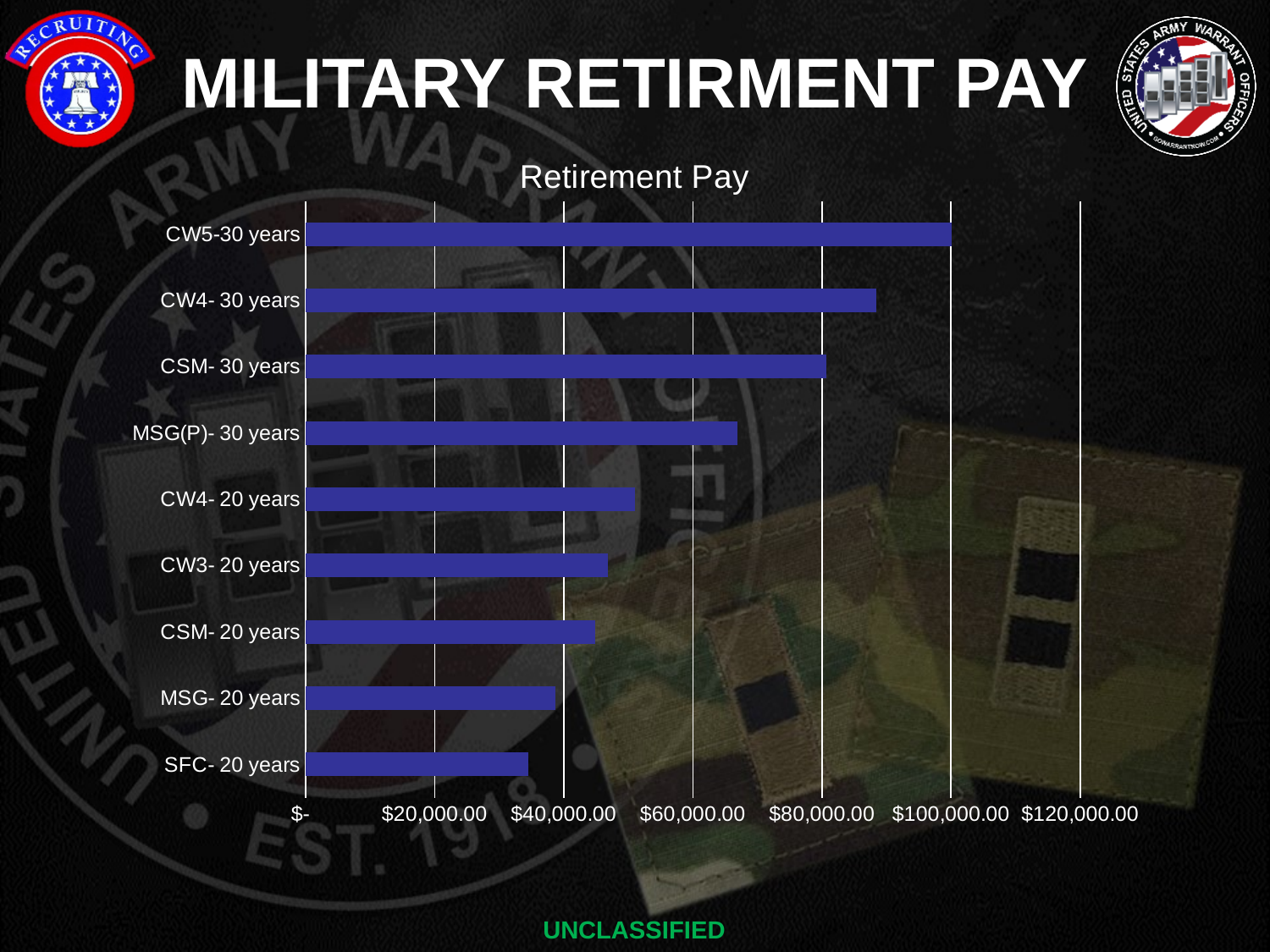
What is the title of the chart? Retirement Pay How many categories are plotted in the chart? 9 Is the value for SFC- 20 years greater or less than $40,000.00? less Is the value for MSG(P)- 30 years greater or less than $60,000.00? greater Which is larger, the value for CW4- 30 years or the value for CSM- 30 years? CW4- 30 years Is the value for CW4- 20 years greater or less than $40,000.00? greater What kind of chart is shown on the slide? bar chart Which is larger, the value for CW4- 20 years or the value for CSM- 20 years? CW4- 20 years Which category has the lowest retirement pay? SFC- 20 years Which category has the highest retirement pay? CW5-30 years